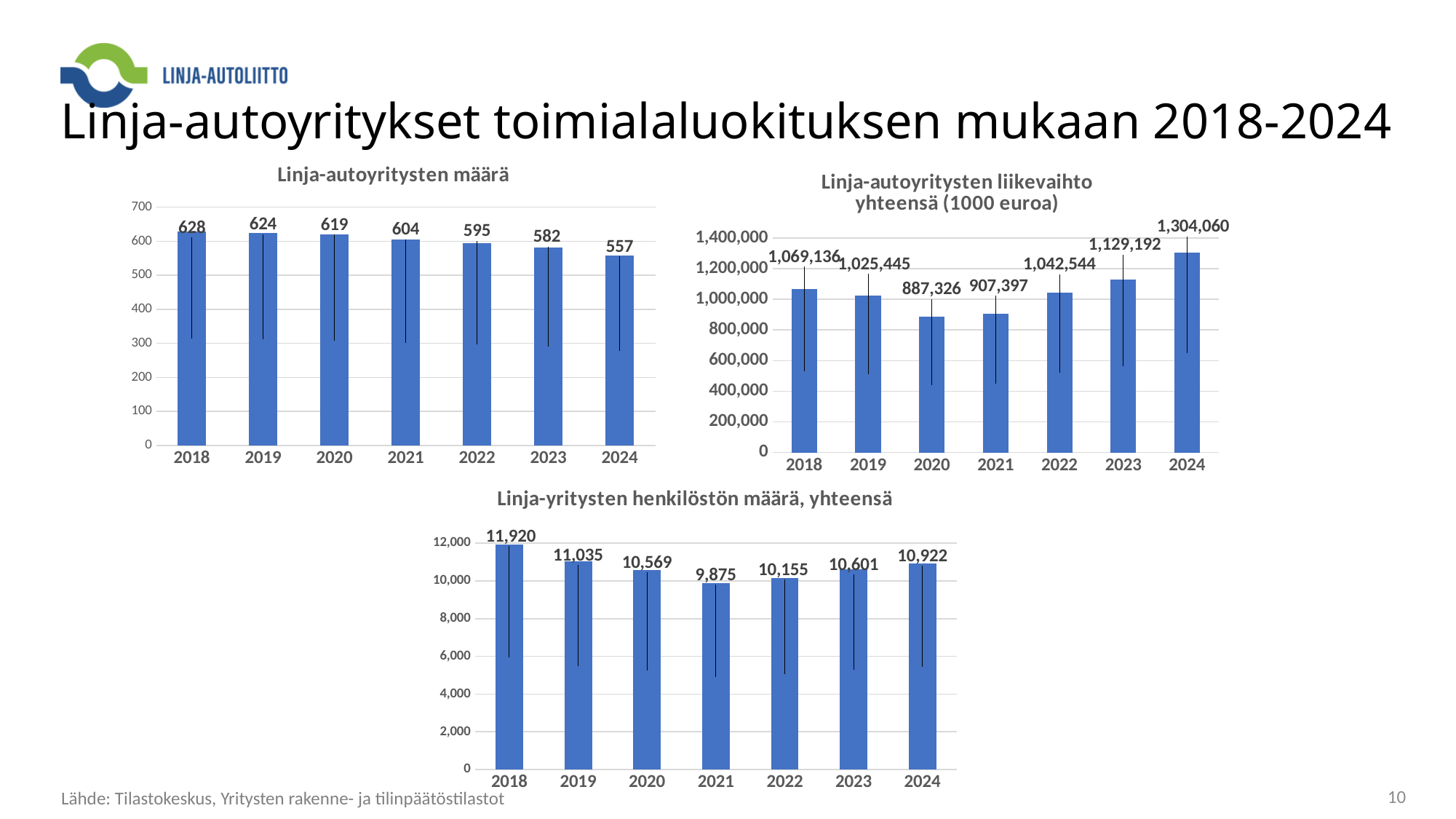
What kind of chart is 'Linja-yritysten henkilöstön määrä, yhteensä'? bar chart In the chart 'Linja-autoyritysten määrä', what is the difference between the 2018 and 2024 values? 71 In the chart 'Linja-yritysten henkilöstön määrä, yhteensä', what is the value for 2023? 10,601 In the chart 'Linja-autoyritysten määrä', what is the value for 2021? 604 In the chart 'Linja-autoyritysten liikevaihto yhteensä (1000 euroa)', what is the difference between the 2024 and 2020 values? 416,734 In the chart 'Linja-yritysten henkilöstön määrä, yhteensä', which year has the lowest value? 2021 In the chart 'Linja-autoyritysten määrä', which year has the lowest value? 2024 In the chart 'Linja-autoyritysten määrä', do the values rise or fall from 2018 to 2024? fall In the chart 'Linja-autoyritysten liikevaihto yhteensä (1000 euroa)', which year has the highest value? 2024 In the chart 'Linja-autoyritysten liikevaihto yhteensä (1000 euroa)', which is larger, the value for 2019 or the value for 2022? 2022 In the chart 'Linja-autoyritysten liikevaihto yhteensä (1000 euroa)', what is the value for 2020? 887,326 In the chart 'Linja-yritysten henkilöstön määrä, yhteensä', how many years are shown on the x axis? 7